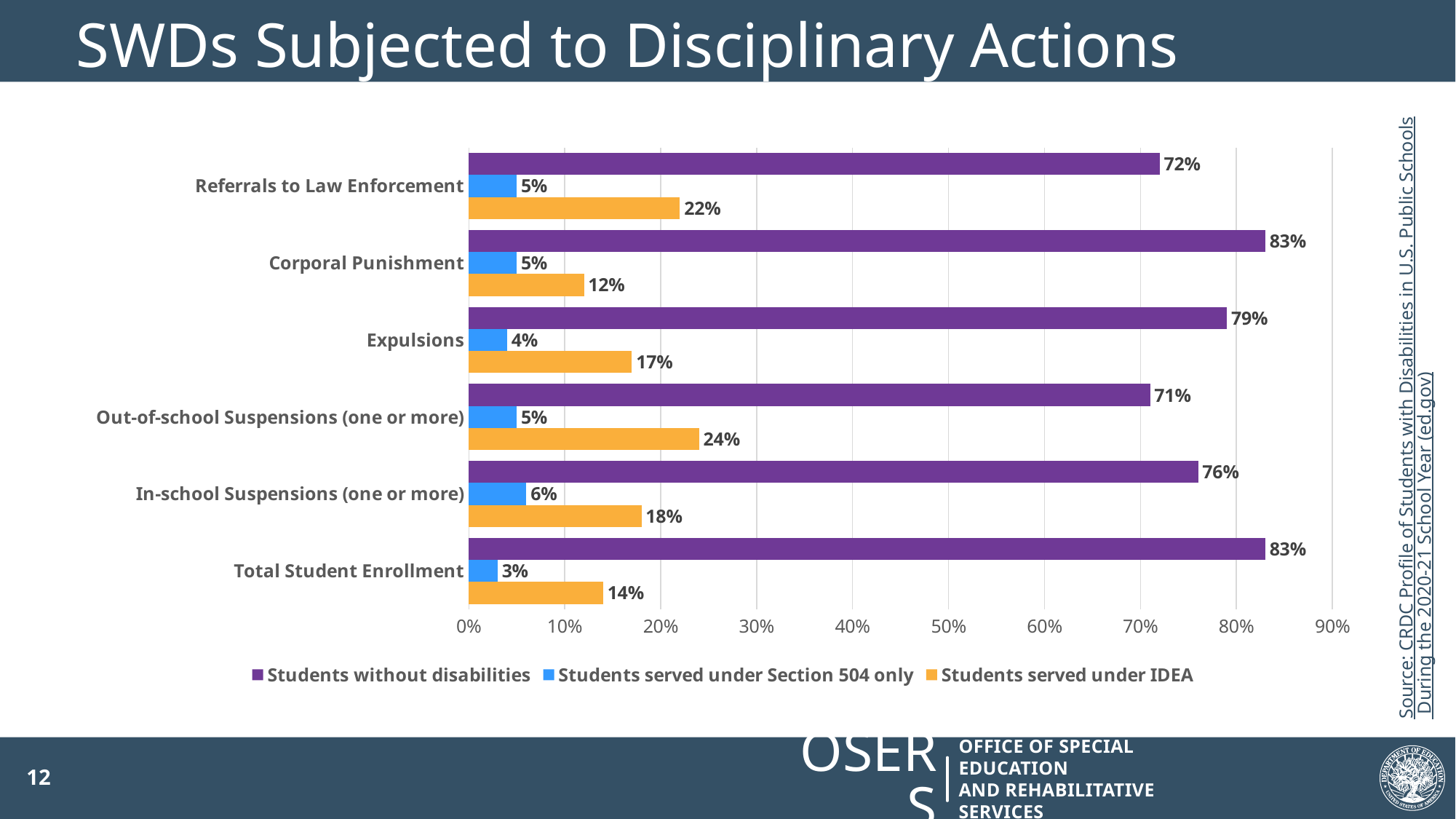
What share of Total Student Enrollment is students served under Section 504 only? 3% What is the difference between the students served under IDEA value for Referrals to Law Enforcement and for Total Student Enrollment? 8% Which category has the lowest value for students served under IDEA? Corporal Punishment Is the value for students without disabilities for Corporal Punishment greater or less than 80%? greater What percentage of students served under IDEA were subjected to out-of-school suspensions (one or more)? 24% How many series does the legend list? 3 How many categories are shown on the y axis of the chart? 6 Which is larger: the students without disabilities value for In-school Suspensions (one or more) or for Out-of-school Suspensions (one or more)? In-school Suspensions (one or more) Which colour represents students served under Section 504 only in the chart? Blue Which category has the highest value for students served under IDEA? Out-of-school Suspensions (one or more) What is the value for students without disabilities for Expulsions? 79% What kind of chart is shown on the slide? Bar chart